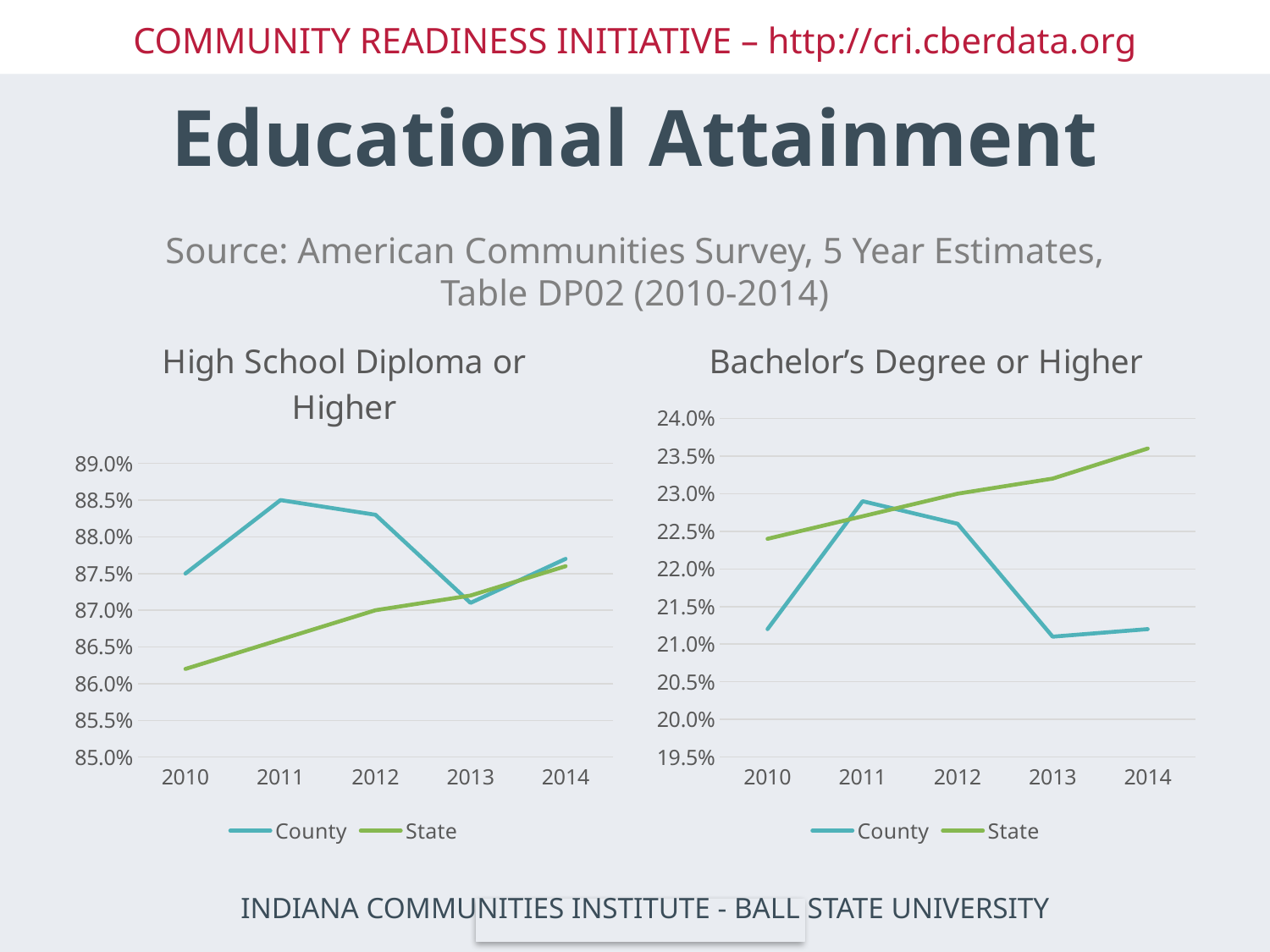
What kind of chart is the 'High School Diploma or Higher' chart? line chart In the 'Bachelor's Degree or Higher' chart, which year has the highest State value? 2014 In the 'High School Diploma or Higher' chart, which year has the lowest State value? 2010 In the 'High School Diploma or Higher' chart, is the State value for 2010 greater or less than 86.5%? less In the 'Bachelor's Degree or Higher' chart, is the County value for 2013 greater or less than 21.5%? less In the 'High School Diploma or Higher' chart, does the State line rise or fall from 2010 to 2014? rise In the 'High School Diploma or Higher' chart, is the County value for 2011 greater or less than 88.0%? greater How many years are shown on the x axis of the 'High School Diploma or Higher' chart? 5 In the 'Bachelor's Degree or Higher' chart, which is larger in 2014, the County value or the State value? State In the 'High School Diploma or Higher' chart, which year has the highest County value? 2011 How many series does the legend of the 'Bachelor's Degree or Higher' chart list? 2